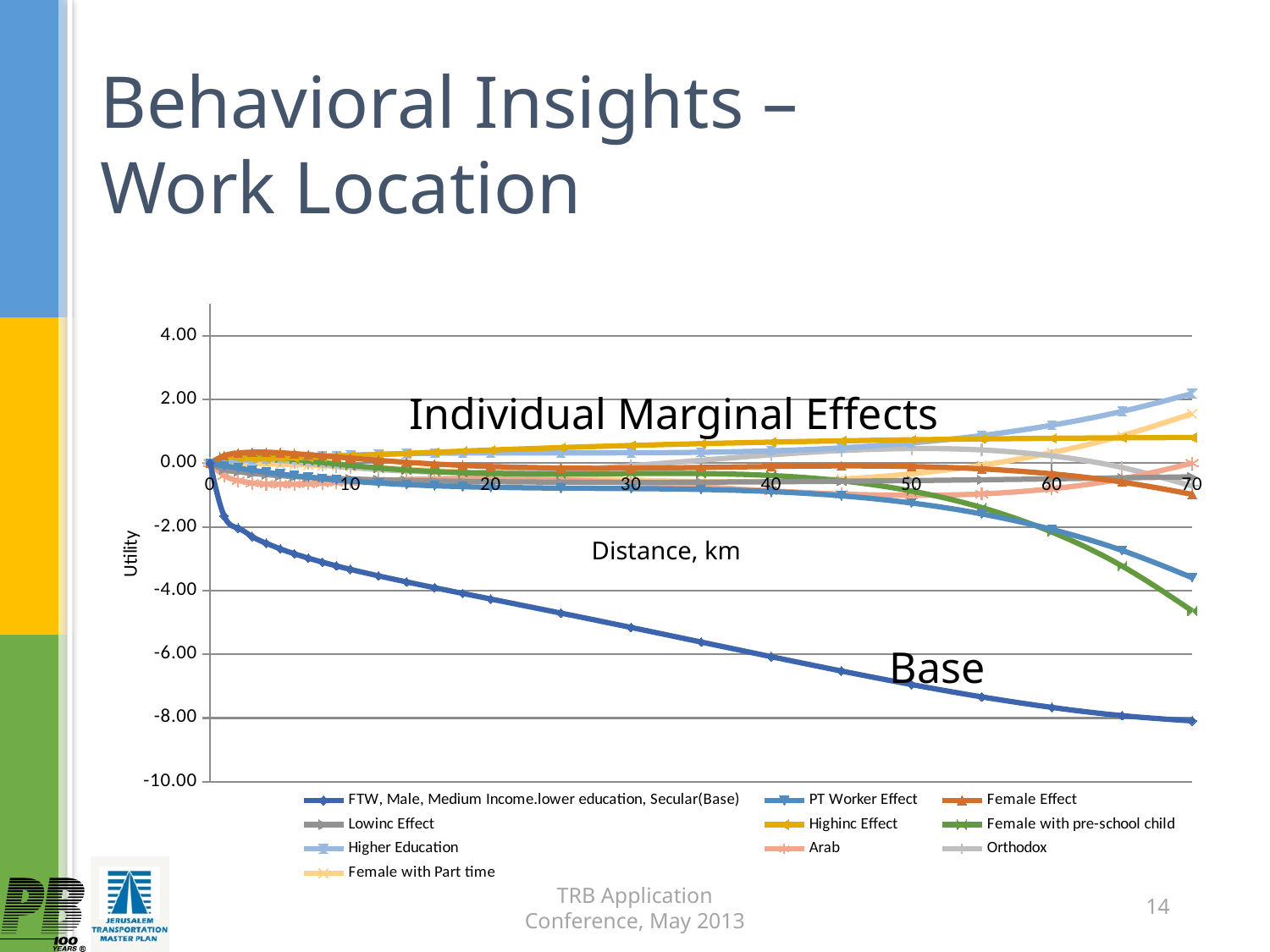
What is the label on the horizontal axis of the chart? Distance, km At 70 km, which series has the highest utility? Higher Education Is the value of the Higher Education series at 70 km greater or less than 0.00? greater Is the value of the Base series at 60 km greater or less than -6.00? less Is the value of the Base series at 30 km greater or less than -4.00? less At 70 km, which series has the lowest utility? FTW, Male, Medium Income.lower education, Secular(Base) How many series does the legend list? 10 Does the Base series (FTW, Male, Medium Income.lower education, Secular) rise or fall as distance increases? fall What kind of chart is shown on the slide? line chart At 70 km, which is larger: the Higher Education series or the Female with pre-school child series? Higher Education What is the label on the vertical axis of the chart? Utility